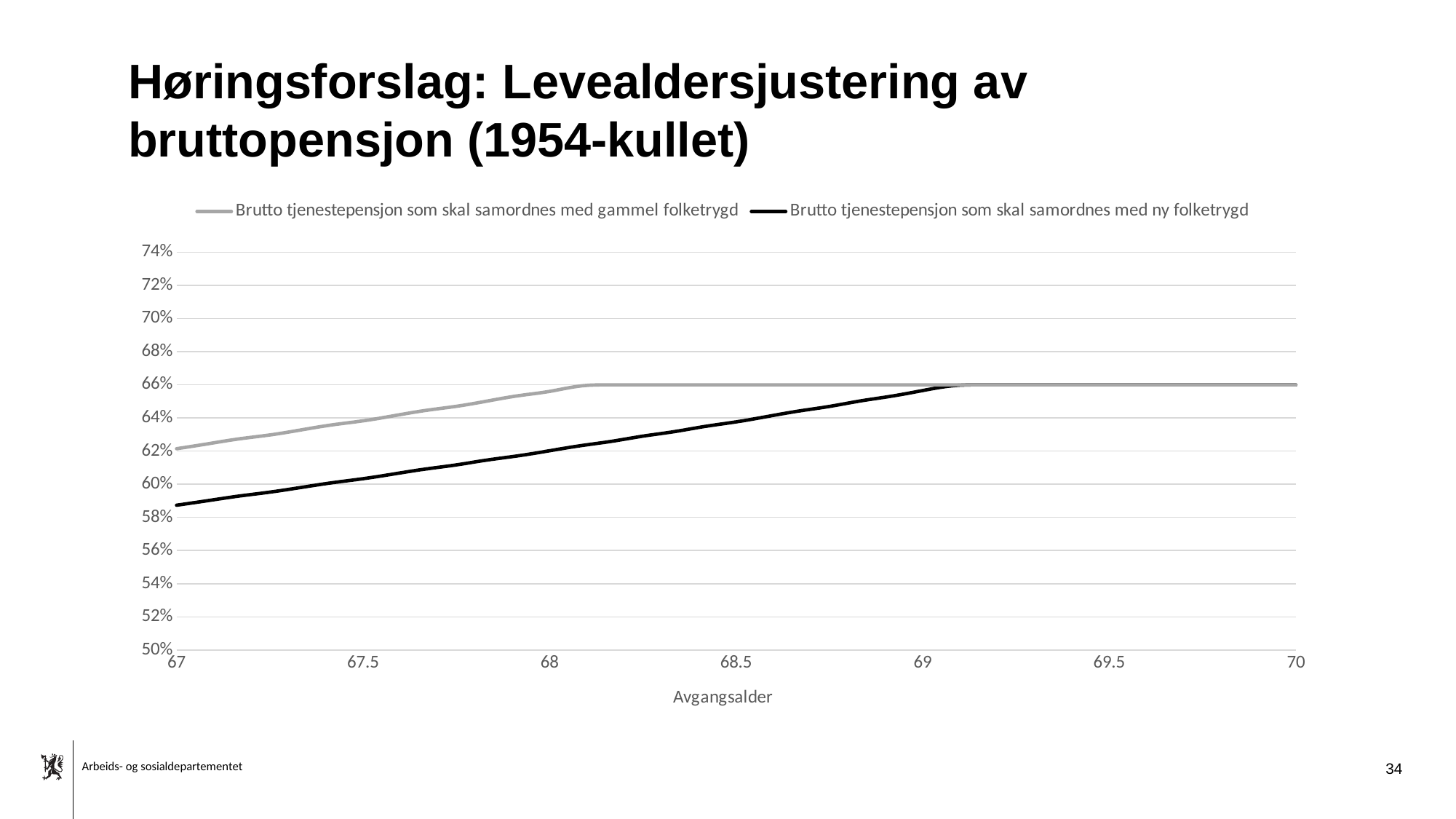
At age 68, which series has the higher value: the one samordnes med gammel folketrygd or the one samordnes med ny folketrygd? Brutto tjenestepensjon som skal samordnes med gammel folketrygd Is the value for 'Brutto tjenestepensjon som skal samordnes med ny folketrygd' at age 67 greater or less than 60%? less Which series is drawn in black? Brutto tjenestepensjon som skal samordnes med ny folketrygd Does the value for 'Brutto tjenestepensjon som skal samordnes med ny folketrygd' rise or fall from age 67 to age 69? rise How many series does the legend list? 2 What value do both series reach at age 70? 66% What kind of chart is shown on the slide? line chart Is the value for 'Brutto tjenestepensjon som skal samordnes med ny folketrygd' at age 68 greater or less than 64%? less Is the value for 'Brutto tjenestepensjon som skal samordnes med gammel folketrygd' at age 68 greater or less than 64%? greater What is the label of the x axis? Avgangsalder Which series has the lower value at age 67? Brutto tjenestepensjon som skal samordnes med ny folketrygd